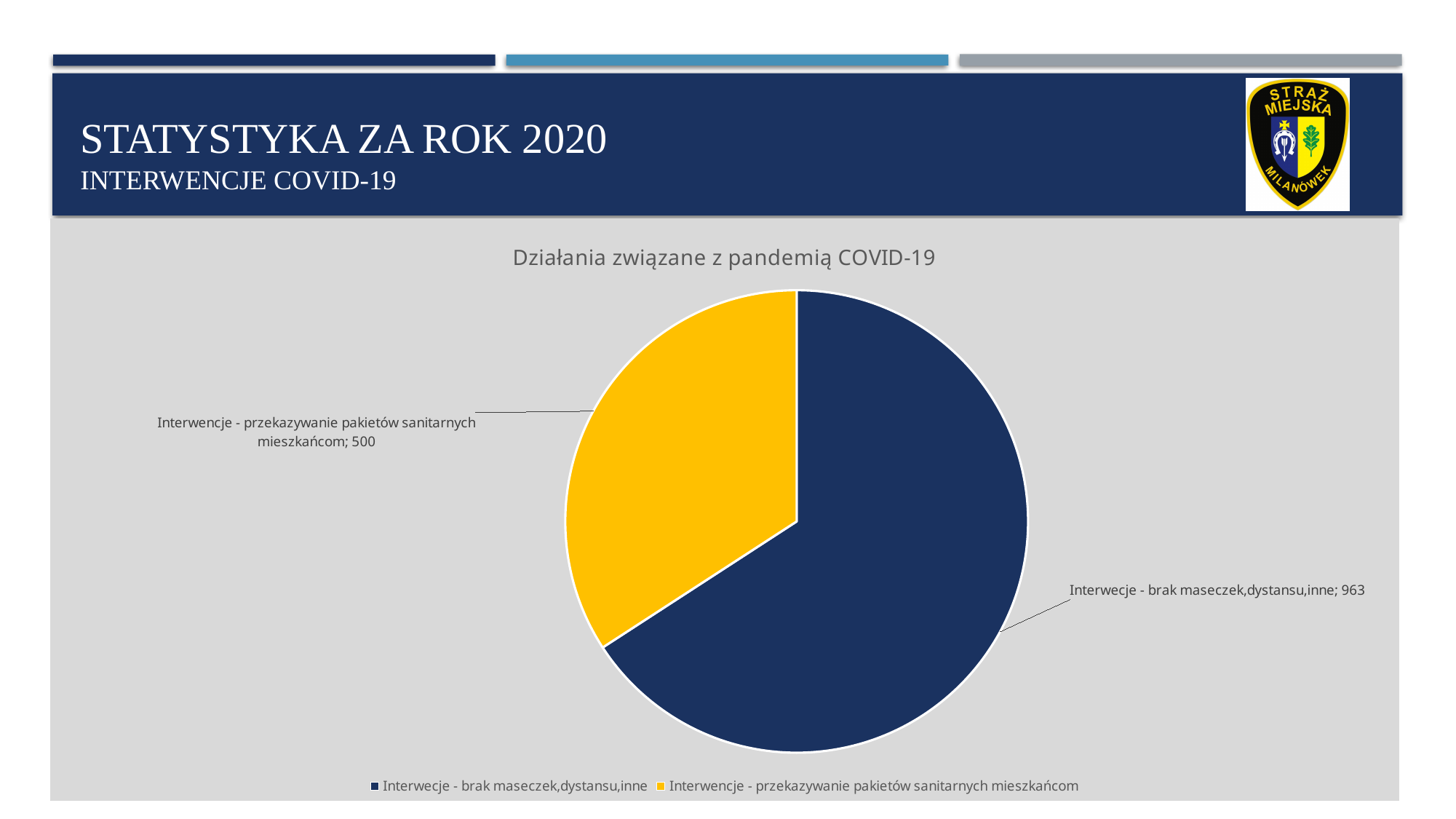
What is the value for 'Interwencje - przekazywanie pakietów sanitarnych mieszkańcom'? 500 Which category has the largest slice of the pie? Interwecje - brak maseczek,dystansu,inne What colour is the slice for 'Interwencje - przekazywanie pakietów sanitarnych mieszkańcom'? Yellow Which is larger: the value for 'Interwecje - brak maseczek,dystansu,inne' or the value for 'Interwencje - przekazywanie pakietów sanitarnych mieszkańcom'? Interwecje - brak maseczek,dystansu,inne What type of chart is shown on the slide? Pie chart What is the total of all slices in the pie chart? 1463 What is the difference between the value for 'Interwecje - brak maseczek,dystansu,inne' and the value for 'Interwencje - przekazywanie pakietów sanitarnych mieszkańcom'? 463 How many slices does the pie chart have? 2 What is the value for 'Interwecje - brak maseczek,dystansu,inne'? 963 Which category has the smallest slice of the pie? Interwencje - przekazywanie pakietów sanitarnych mieszkańcom What share of the pie does 'Interwecje - brak maseczek,dystansu,inne' represent, to the nearest whole percent? 66% What is the title of the chart? Działania związane z pandemią COVID-19